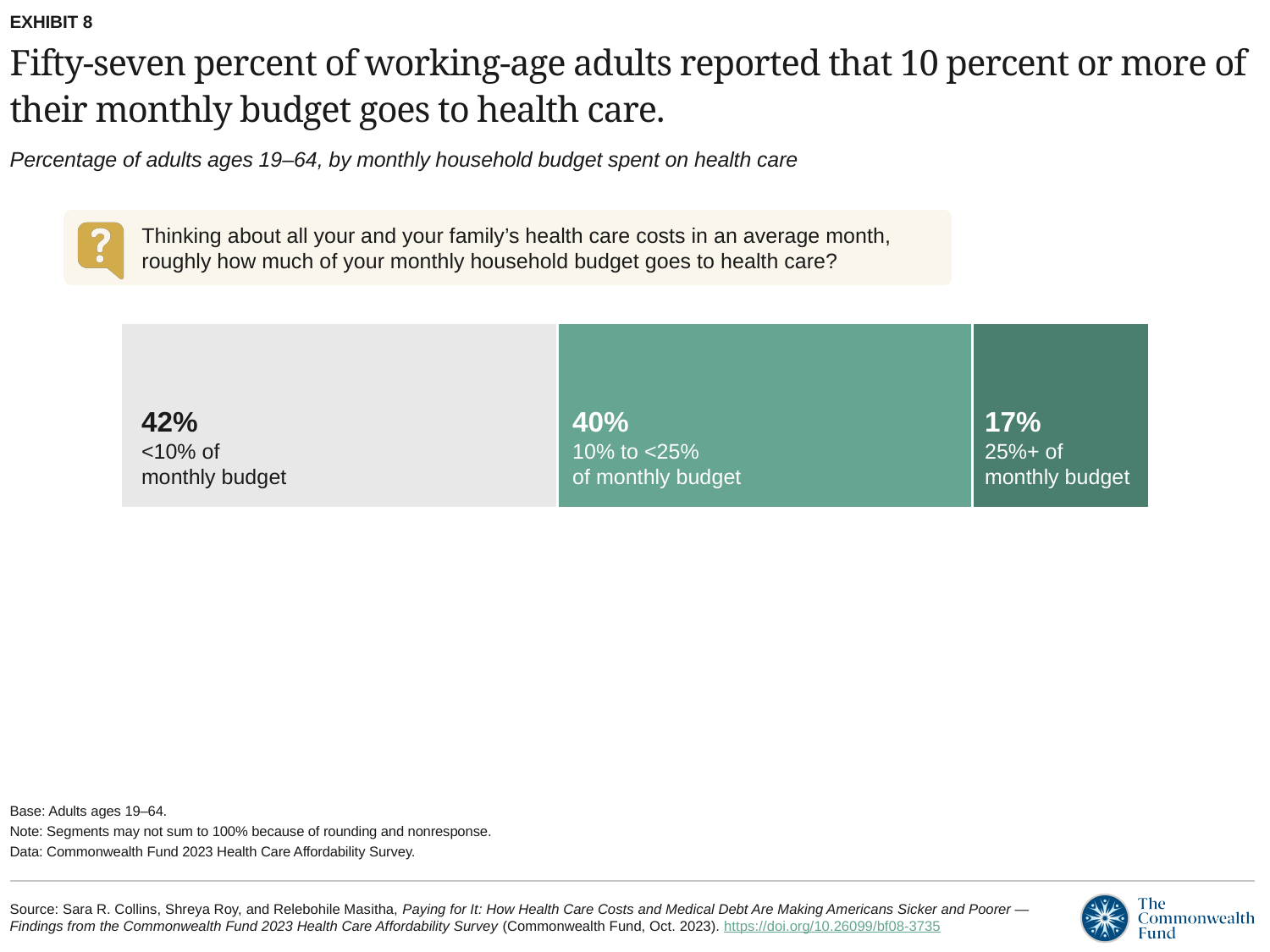
What percentage of adults reported that less than 10% of their monthly budget goes to health care? 42% What percentage of adults reported that 25%+ of their monthly budget goes to health care? 17% Which budget category has the smallest share of adults? 25%+ of monthly budget What is the difference in percentage points between the 10% to <25% category and the 25%+ category? 23 Which budget category has the largest share of adults? <10% of monthly budget What is the combined percentage of adults who reported 10% or more of their monthly budget goes to health care? 57% What percentage of adults reported spending 10% to <25% of their monthly budget on health care? 40% Which segment of the bar is shaded the darkest green? 25%+ of monthly budget Which is larger: the share for <10% of monthly budget or the share for 10% to <25% of monthly budget? <10% of monthly budget What kind of chart is shown on the slide? Stacked bar chart What is the difference in percentage points between the <10% category and the 25%+ category? 25 How many budget categories are shown in the chart? 3